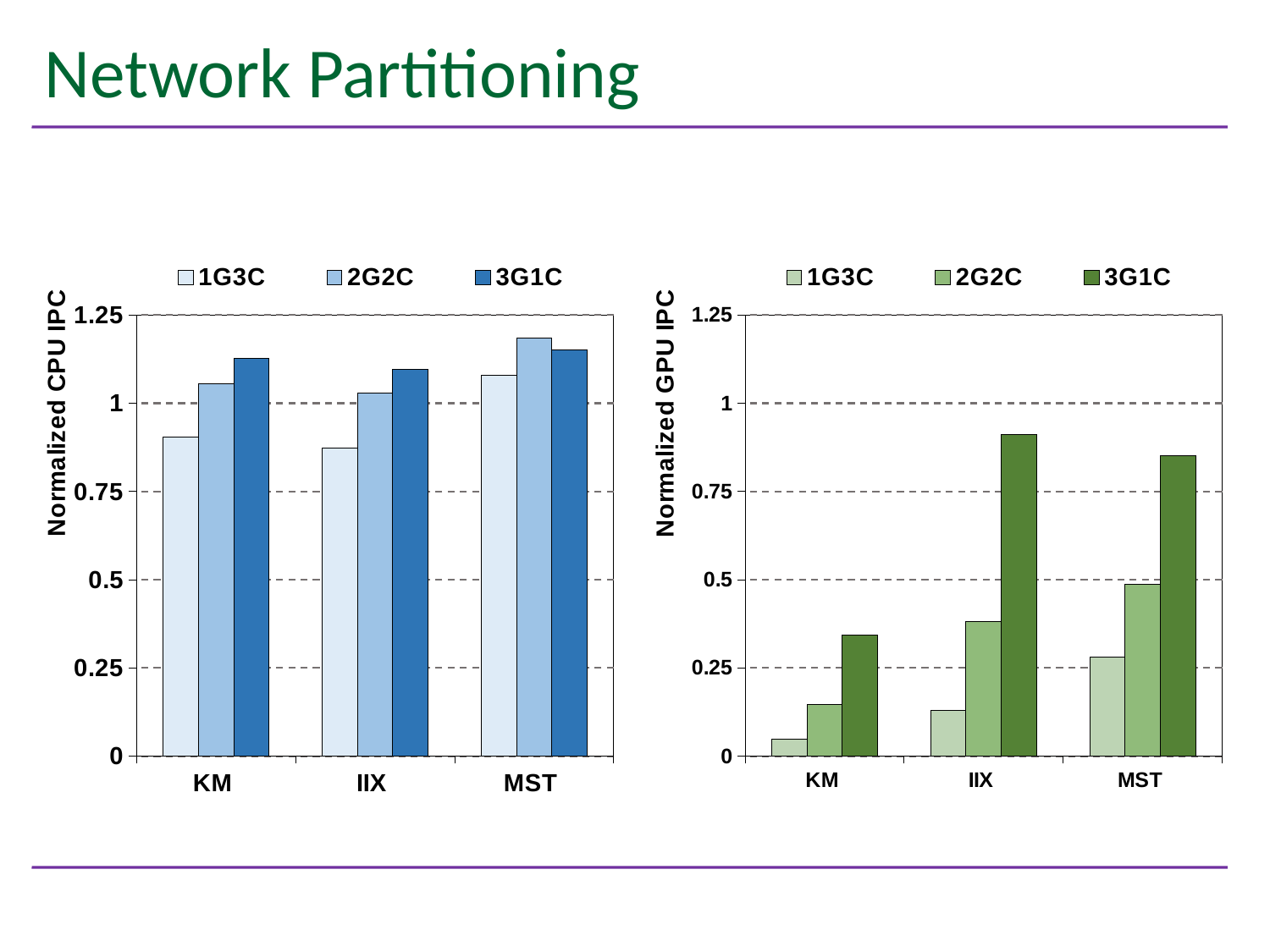
In the Normalized GPU IPC chart, which category has the lowest 1G3C value? KM In the Normalized GPU IPC chart, is the value for 3G1C at KM greater or less than 0.25? greater In the Normalized GPU IPC chart, is the value for 1G3C at KM greater or less than 0.25? less In the Normalized GPU IPC chart, do the 1G3C values rise or fall from KM to MST? rise What kind of chart is the Normalized GPU IPC chart? bar chart How many series does the legend of the Normalized CPU IPC chart list? 3 In the Normalized GPU IPC chart, which is larger: 3G1C at IIX or 3G1C at MST? 3G1C at IIX In the Normalized CPU IPC chart, which series has the highest value for KM? 3G1C In the Normalized CPU IPC chart, is the value for 3G1C at KM greater or less than 1? greater